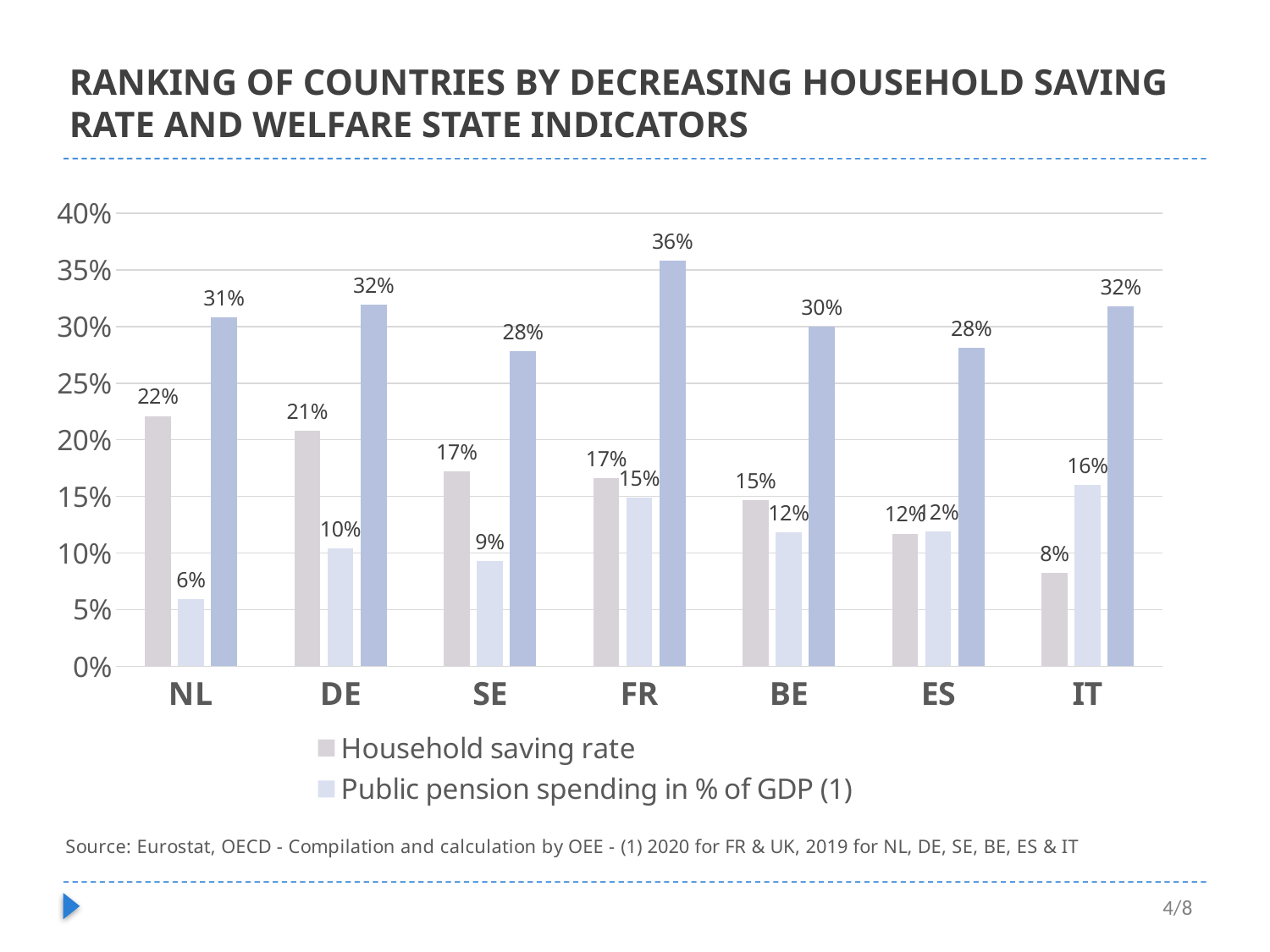
How many series does the legend list? 2 Does the household saving rate rise or fall from NL to IT along the x axis? Fall How many countries are shown on the x axis? 7 What is the difference between the household saving rate of NL and that of IT? 14% What kind of chart is shown on the slide? Bar chart Which country has the lowest household saving rate? IT Which is larger: the household saving rate for DE or the public pension spending in % of GDP for DE? Household saving rate for DE What is the household saving rate for NL? 22% What is the public pension spending in % of GDP for IT? 16% Which country has the highest household saving rate? NL Which country has the lowest public pension spending in % of GDP? NL What is the household saving rate for BE? 15%